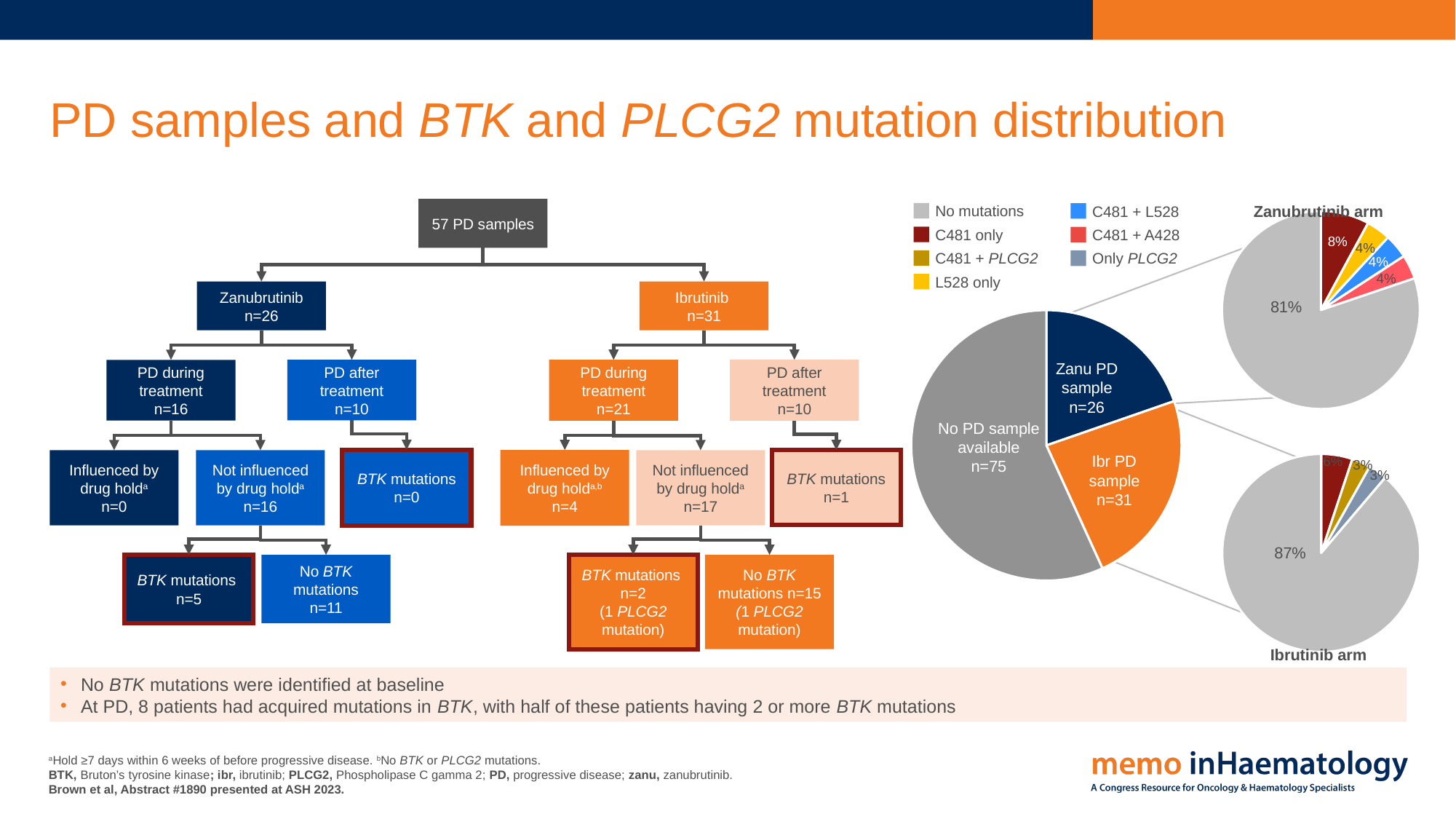
In the Ibrutinib arm pie chart, what percentage of samples had no mutations? 87% In the large pie chart, which slice is the largest? No PD sample available In the large pie chart, what is the value for 'Zanu PD sample'? n=26 In the Zanubrutinib arm pie chart, what percentage is shown for the C481 only slice? 8% Which arm's pie chart shows a larger share of samples with no mutations, Zanubrutinib or Ibrutinib? Ibrutinib How many mutation categories does the legend for the arm pie charts list? 7 In the large pie chart, how many slices are there? 3 In the large pie chart, what is the value for 'No PD sample available'? n=75 In the large pie chart, what is the value for 'Ibr PD sample'? n=31 In the Zanubrutinib arm pie chart, what percentage of samples had no mutations? 81% In the large pie chart, what is the difference between the Ibr PD sample and Zanu PD sample counts? 5 In the large pie chart, which slice is the smallest? Zanu PD sample